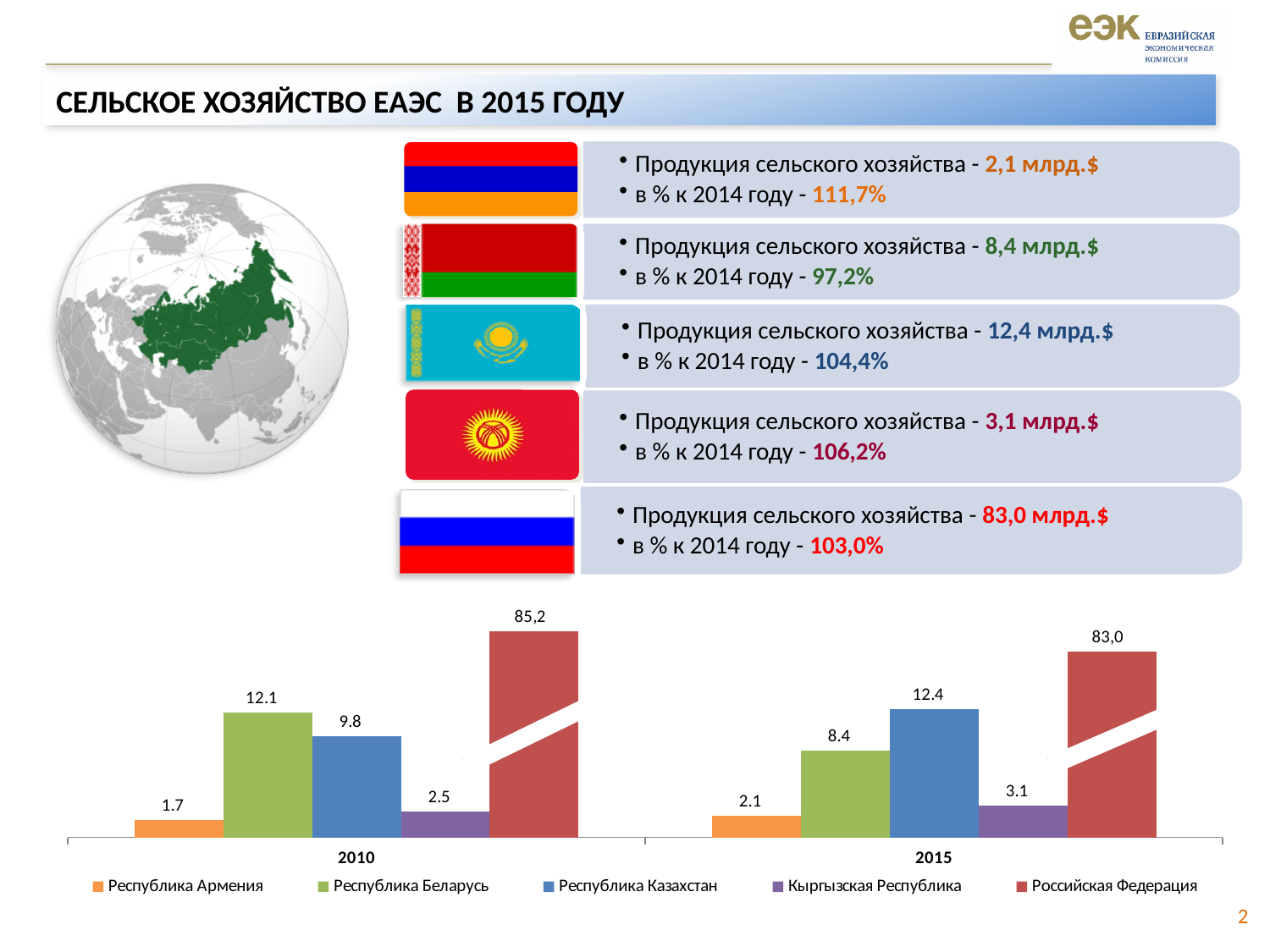
Does the value for Республика Беларусь rise or fall from 2010 to 2015? fall How many categories are shown on the x axis of the bar chart? 2 Which series has the lowest value in 2015? Республика Армения What is the value for Кыргызская Республика in 2015? 3.1 What kind of chart is shown at the bottom of the slide? bar chart What is the value for Республика Беларусь in 2010? 12.1 What is the difference between the values for Республика Казахстан in 2015 and 2010? 2.6 How many series does the legend of the bar chart list? 5 What is the value for Российская Федерация in 2010? 85,2 Which series has the highest value in 2010? Российская Федерация Which is larger in 2015: Республика Беларусь or Республика Казахстан? Республика Казахстан What is the value for Республика Казахстан in 2015? 12.4